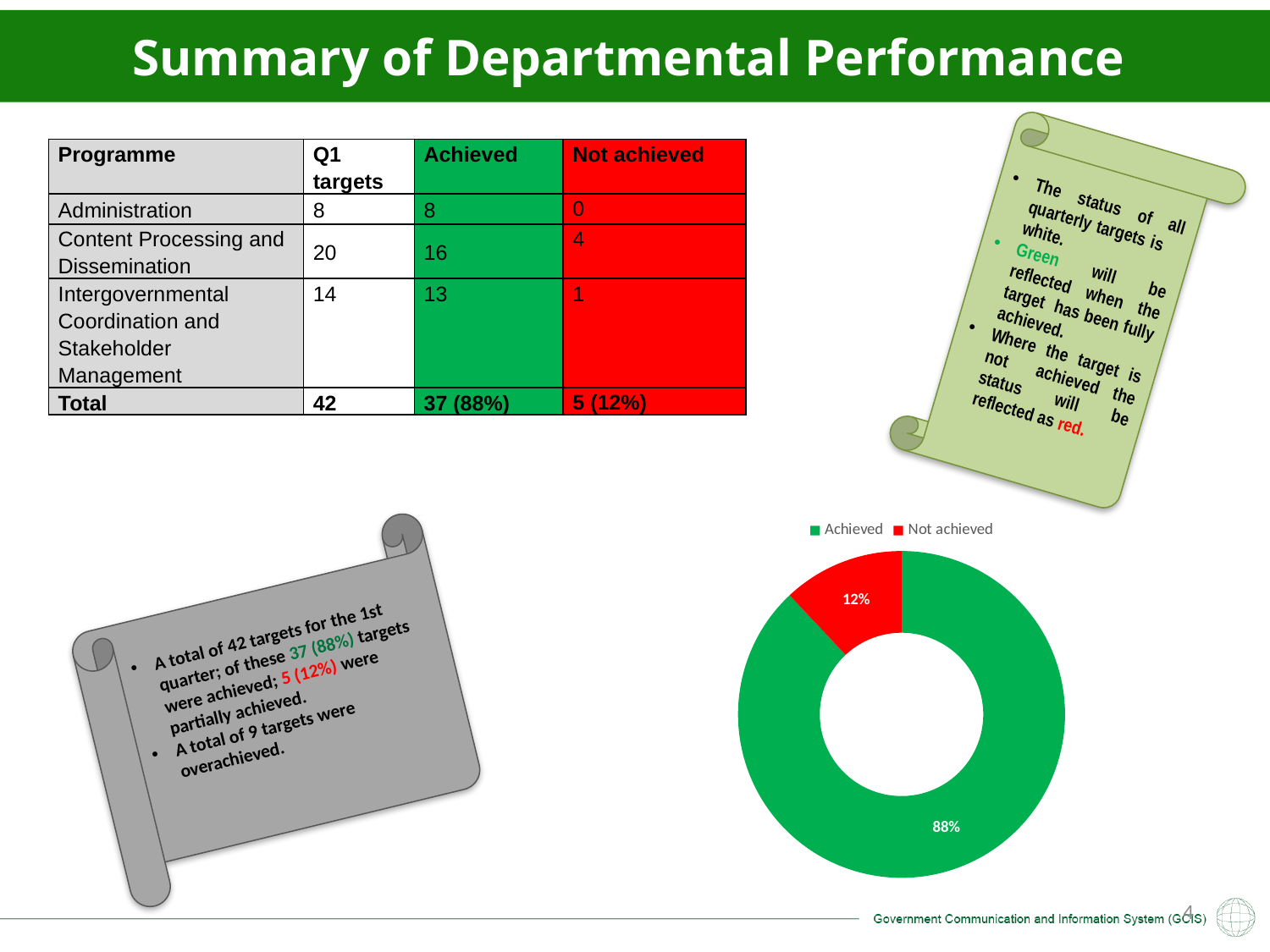
How many slices does the chart have? 2 What share of the chart does the Not achieved slice represent? 12% What percentage does the chart show for Achieved? 88% Which slice of the chart is the smallest? Not achieved What colour is the Not achieved slice in the chart? Red What colour is the Achieved slice in the chart? Green How many entries does the chart legend list? 2 Which is larger in the chart, Achieved or Not achieved? Achieved What kind of chart is shown on the slide? Doughnut (pie) chart What is the difference in percentage points between the Achieved and Not achieved slices? 76 Which slice of the chart is the largest? Achieved What percentage does the chart show for Not achieved? 12%